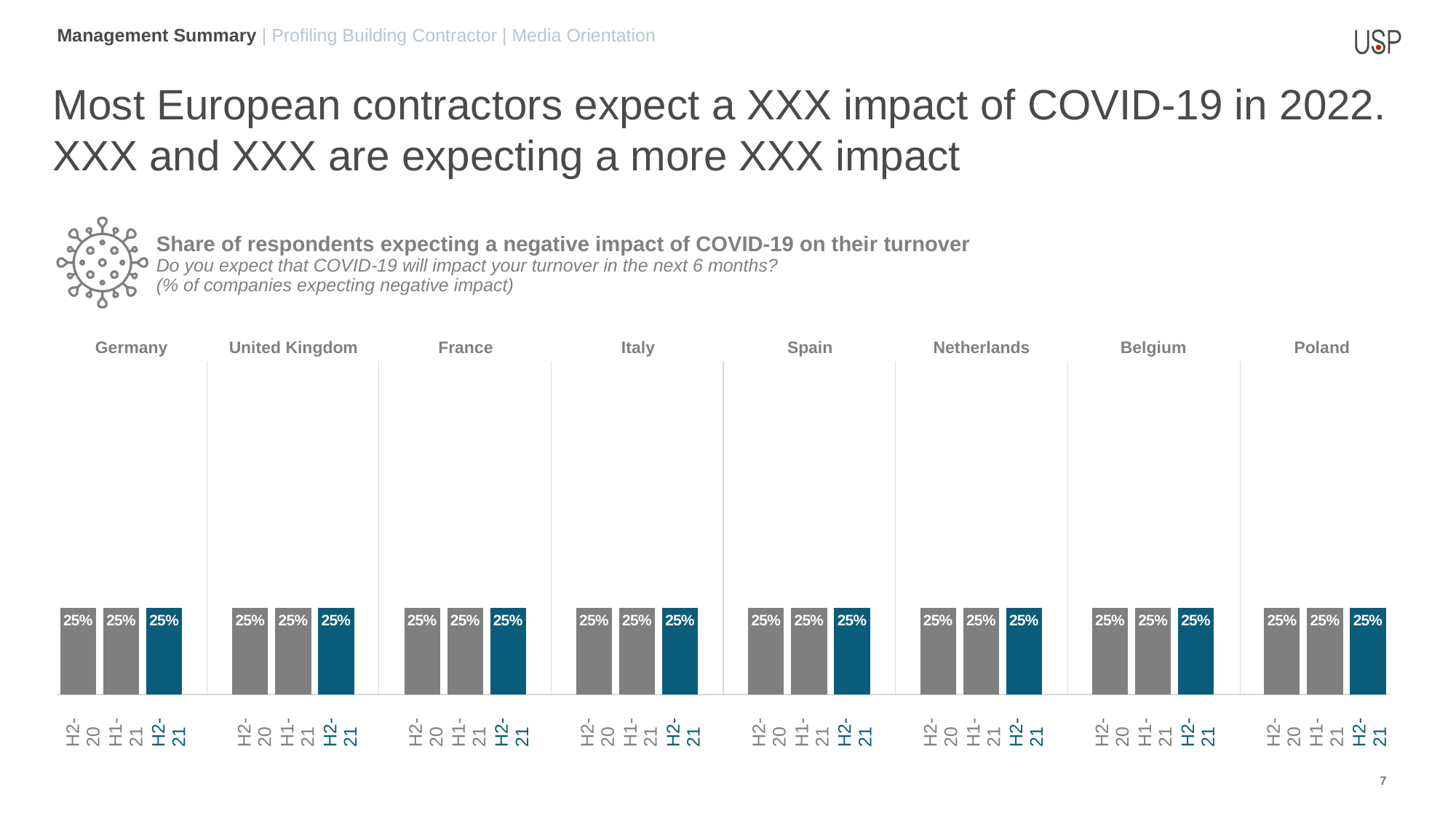
What is the title of the chart section on the slide? Share of respondents expecting a negative impact of COVID-19 on their turnover In the Belgium chart, do the values rise, fall or stay flat from H2-20 to H2-21? Stay flat What kind of chart is used for the Netherlands data? Bar chart In the Germany chart, what is the value for H2-21? 25% In the United Kingdom chart, what is the value for H2-20? 25% In the Germany chart, is the value for H1-21 greater or less than 50%? less In the Poland chart, what is the value for H2-21? 25% In the Poland chart, which period's bar is shown in a different colour (blue) from the others? H2-21 How many country charts are shown on the slide? 8 In the Italy chart, what is the difference between the H2-21 value and the H2-20 value? 0% In the France chart, what is the value for H1-21? 25% In the Spain chart, how many bars are plotted? 3